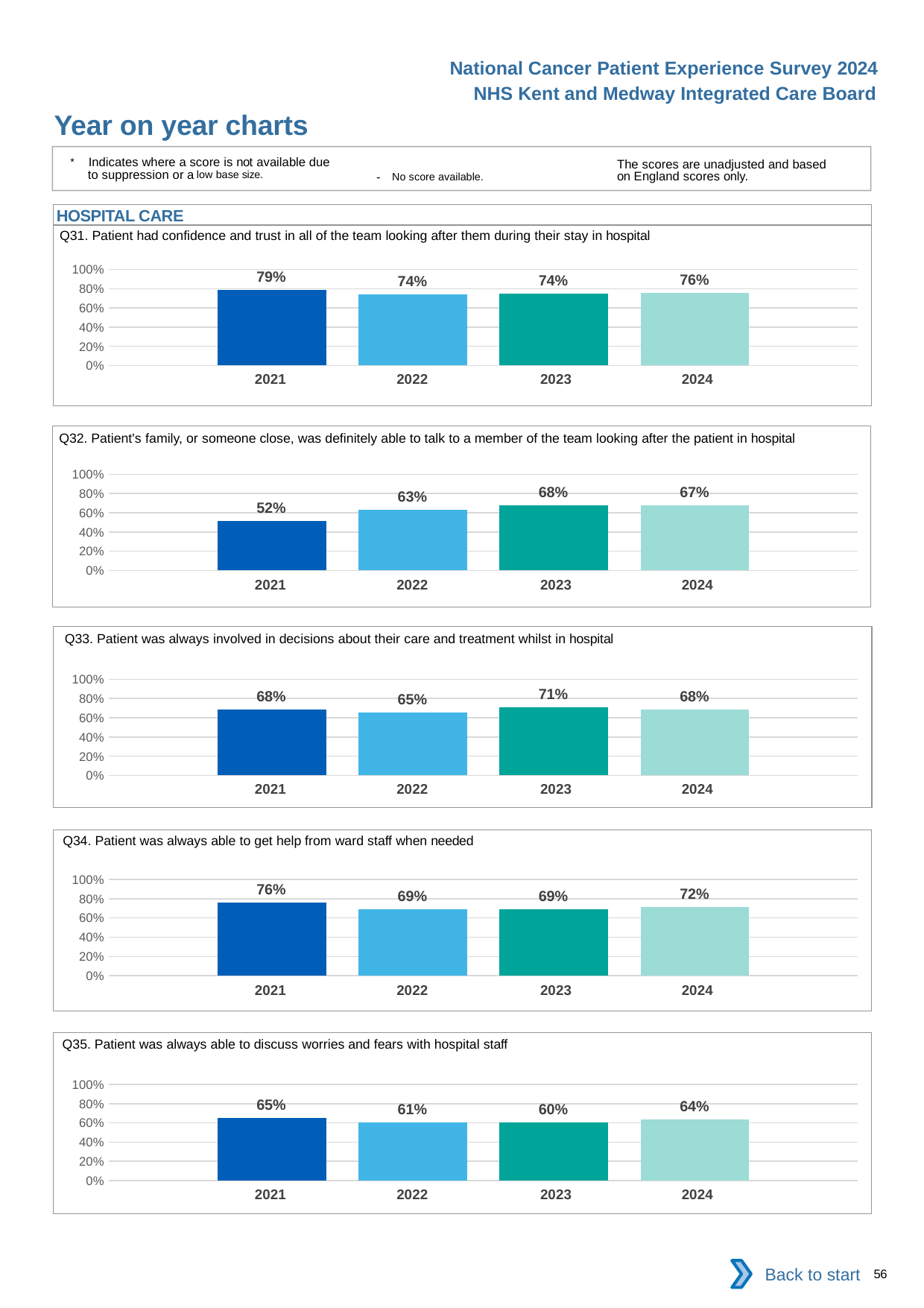
In the Q33 chart (involved in decisions about care and treatment), what is the difference between the 2023 and 2024 values? 3% In the Q35 chart (able to discuss worries and fears), what is the value for 2024? 64% In the Q32 chart (family able to talk to a member of the team), is the value for 2023 larger or smaller than the value for 2022? larger In the Q31 chart (confidence and trust in the team), what is the value for 2021? 79% What kind of chart is the Q34 chart (able to get help from ward staff)? bar chart How many charts are shown under the HOSPITAL CARE section on the slide? 5 In the Q32 chart (family able to talk to a member of the team), which year has the lowest value? 2021 In the Q32 chart (family able to talk to a member of the team), do the values rise or fall from 2021 to 2023? rise In the Q34 chart (able to get help from ward staff), what is the difference between the 2021 and 2022 values? 7% In the Q33 chart (involved in decisions about care and treatment), which year has the highest value? 2023 How many years are plotted in the Q31 chart (confidence and trust in the team)? 4 In the Q35 chart (able to discuss worries and fears), is the value for 2023 greater or less than 80%? less